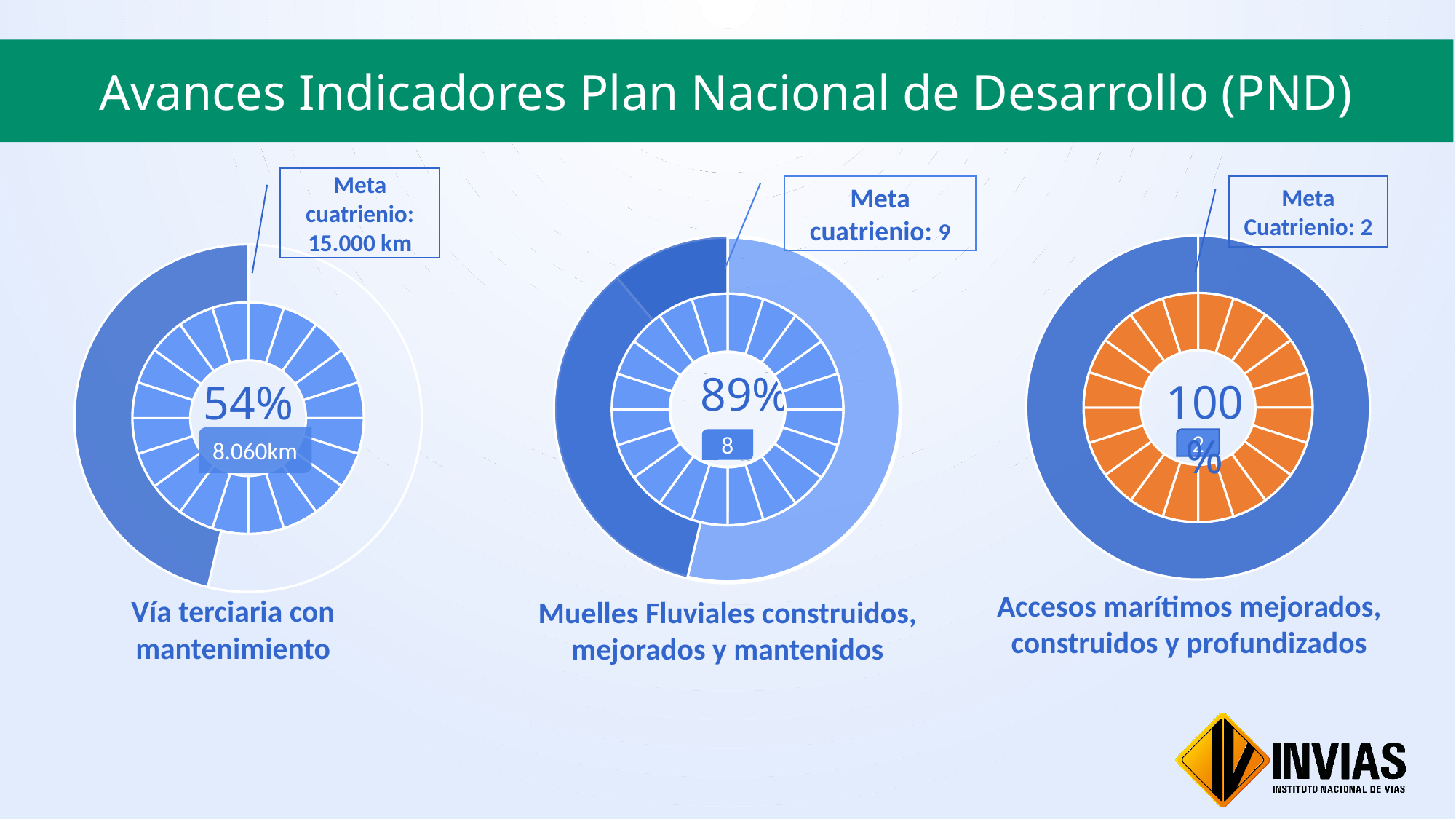
What is the difference in percentage points between the middle chart (89%) and the left chart (54%)? 35 percentage points How many donut charts are shown on the slide? 3 Which of the three charts shows the lowest percentage of progress? Vía terciaria con mantenimiento Which of the three charts shows the highest percentage of progress? Accesos marítimos mejorados, construidos y profundizados In the left chart, 'Vía terciaria con mantenimiento', what is the achieved value shown below the percentage? 8.060km What percentage is shown in the centre of the right chart, 'Accesos marítimos mejorados, construidos y profundizados'? 100% In the middle chart, 'Muelles Fluviales construidos, mejorados y mantenidos', what is the achieved count shown below the percentage? 8 What percentage is shown in the centre of the left chart, 'Vía terciaria con mantenimiento'? 54% What percentage is shown in the centre of the middle chart, 'Muelles Fluviales construidos, mejorados y mantenidos'? 89% What is the 'Meta cuatrienio' for the left chart, 'Vía terciaria con mantenimiento'? 15.000 km What is the 'Meta Cuatrienio' for the right chart, 'Accesos marítimos mejorados, construidos y profundizados'? 2 What is the 'Meta cuatrienio' for the middle chart, 'Muelles Fluviales construidos, mejorados y mantenidos'? 9